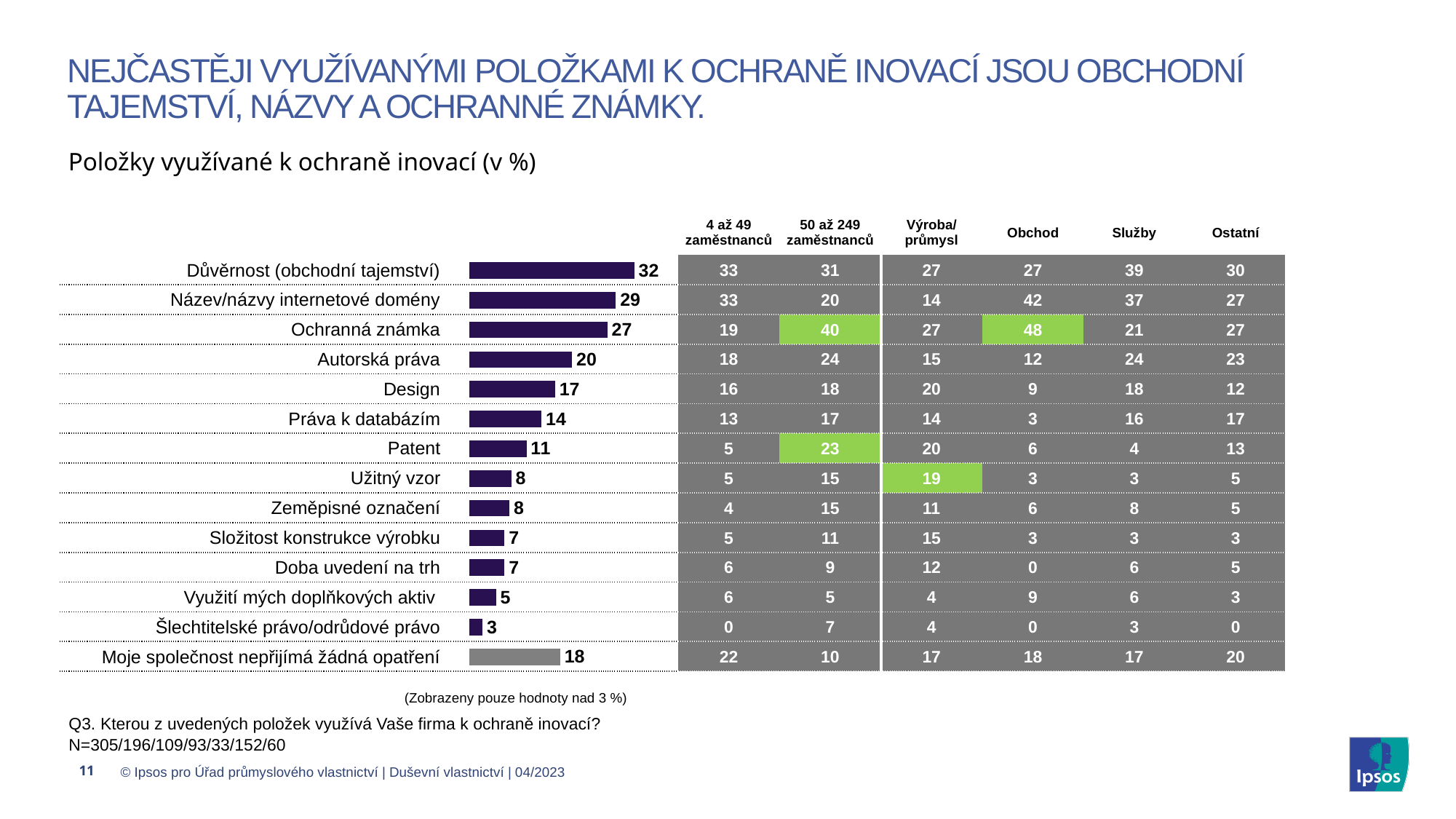
Which has a larger value in the bar chart, Práva k databázím or Užitný vzor? Práva k databázím Which category has the highest value in the bar chart? Důvěrnost (obchodní tajemství) What kind of chart is shown on the slide? bar chart What is the value for Autorská práva in the bar chart? 20 Which category has the lowest value in the bar chart? Šlechtitelské právo/odrůdové právo What is the value for Moje společnost nepřijímá žádná opatření in the bar chart? 18 Which bar in the chart is coloured grey instead of dark purple? Moje společnost nepřijímá žádná opatření Which has a larger value in the bar chart, Design or Patent? Design What is the difference between the values for Důvěrnost (obchodní tajemství) and Název/názvy internetové domény in the bar chart? 3 How many categories are shown in the bar chart? 14 What is the value for Důvěrnost (obchodní tajemství) in the bar chart? 32 What is the difference between the values for Ochranná známka and Autorská práva in the bar chart? 7